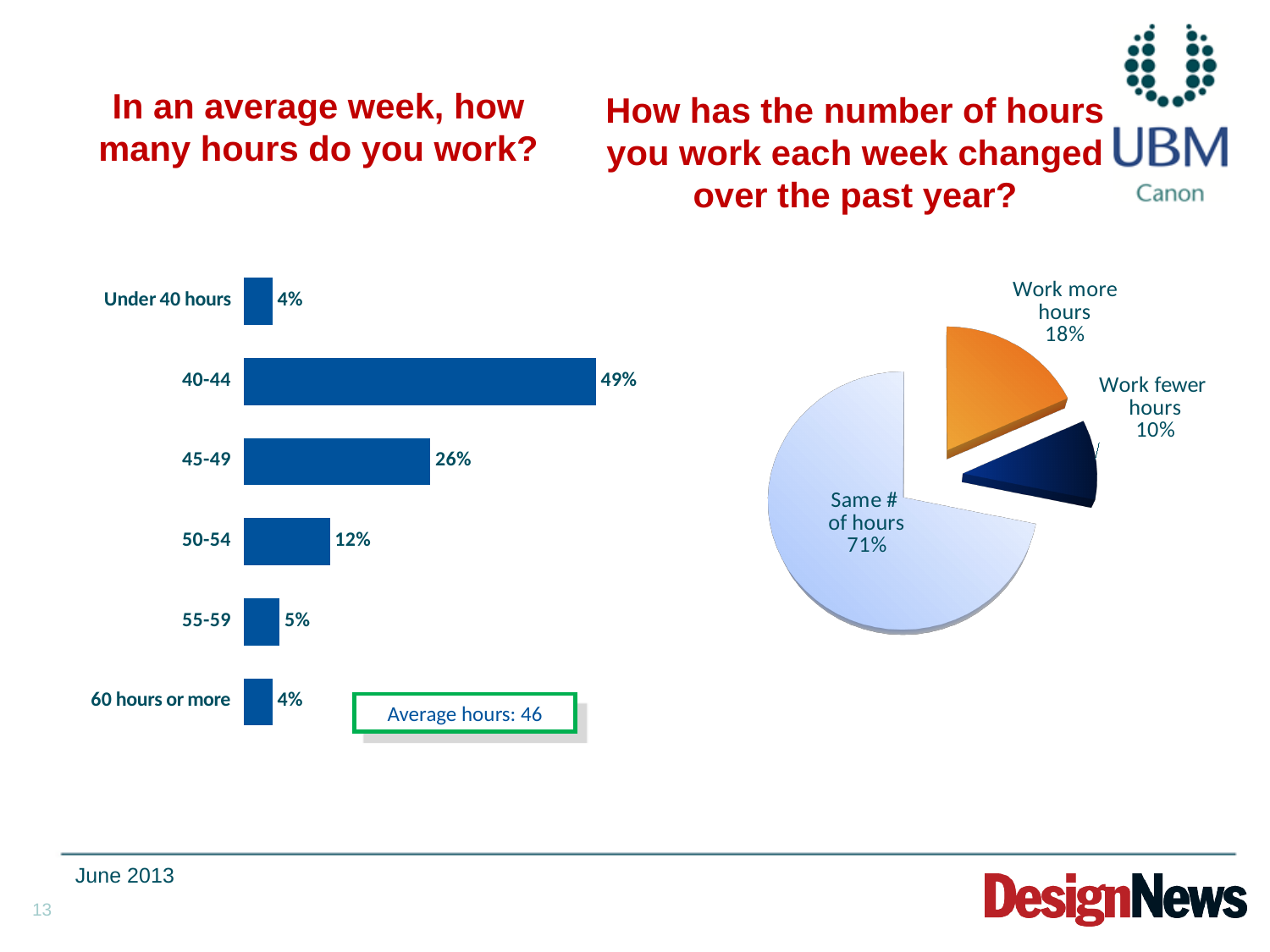
In the 'How has the number of hours you work each week changed over the past year?' chart, what share of respondents work the same number of hours? 71% What kind of chart is the 'In an average week, how many hours do you work?' chart? Bar chart How many categories are shown in the 'In an average week, how many hours do you work?' chart? 6 In the 'In an average week, how many hours do you work?' chart, what percentage of respondents work 40-44 hours? 49% In the 'How has the number of hours you work each week changed over the past year?' chart, which slice is the smallest? Work fewer hours In the 'In an average week, how many hours do you work?' chart, what percentage of respondents work 45-49 hours? 26% In the 'How has the number of hours you work each week changed over the past year?' chart, what share of respondents work fewer hours? 10% In the 'In an average week, how many hours do you work?' chart, which category has the highest value? 40-44 In the 'In an average week, how many hours do you work?' chart, which is larger: the value for 50-54 or the value for 55-59? 50-54 What average number of hours is stated on the left chart? 46 In the 'In an average week, how many hours do you work?' chart, what is the difference between the 40-44 and 45-49 values? 23% What kind of chart is the 'How has the number of hours you work each week changed over the past year?' chart? Pie chart